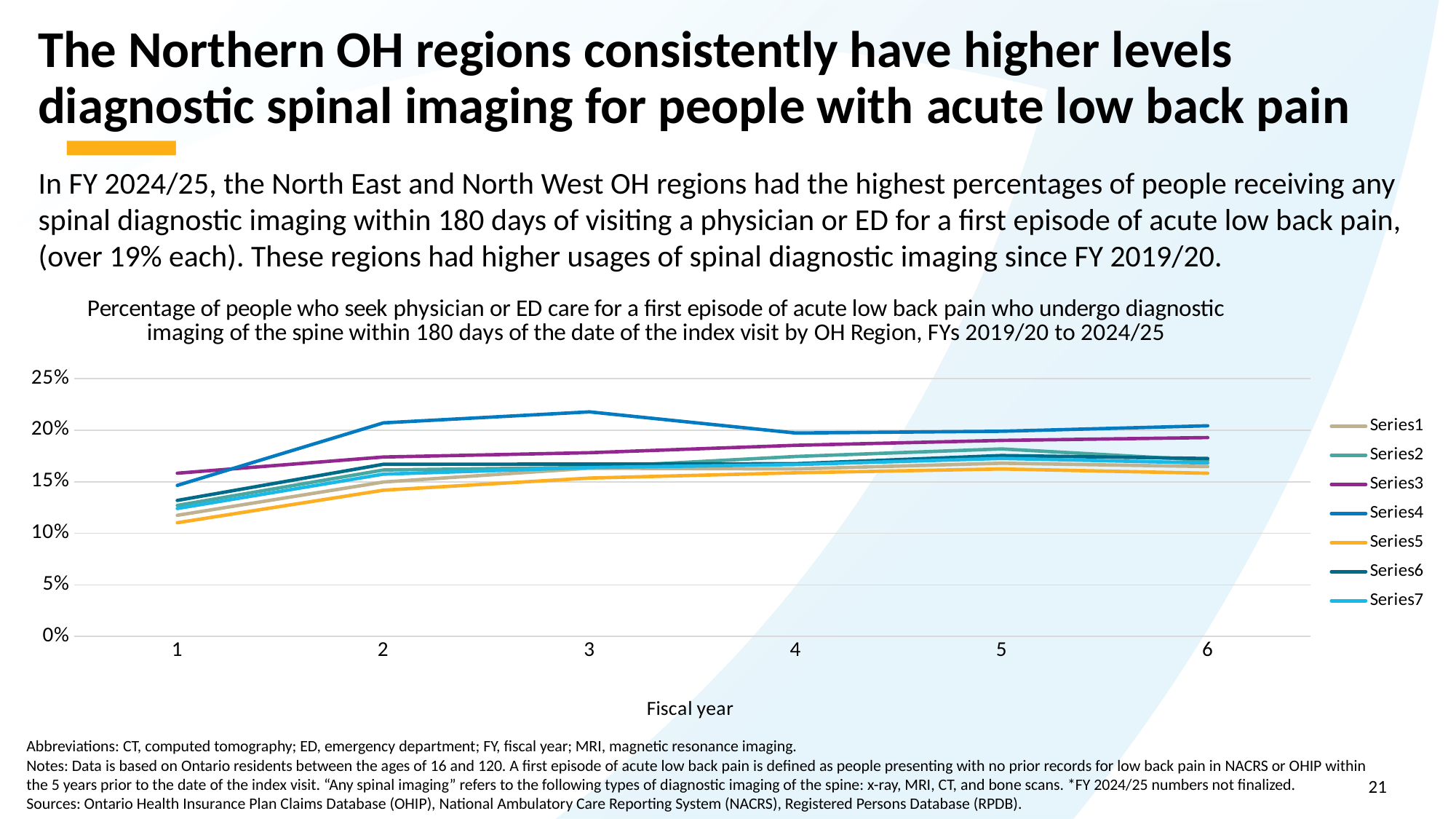
How many fiscal year points are plotted along the x axis? 6 Which series has the lowest value at fiscal year 1? Series5 What is the title of the x axis? Fiscal year What kind of chart is shown on the slide? line chart Which series has the highest value at fiscal year 3? Series4 Is the value for Series5 at fiscal year 6 greater or less than 20%? less At fiscal year 2, which is larger: Series4 or Series5? Series4 Is the value for Series5 at fiscal year 1 greater or less than 15%? less How many series does the legend list? 7 What is the highest tick label shown on the y axis? 25% Does Series3 rise or fall from fiscal year 1 to fiscal year 6? rises Is the value for Series4 at fiscal year 3 greater or less than 20%? greater